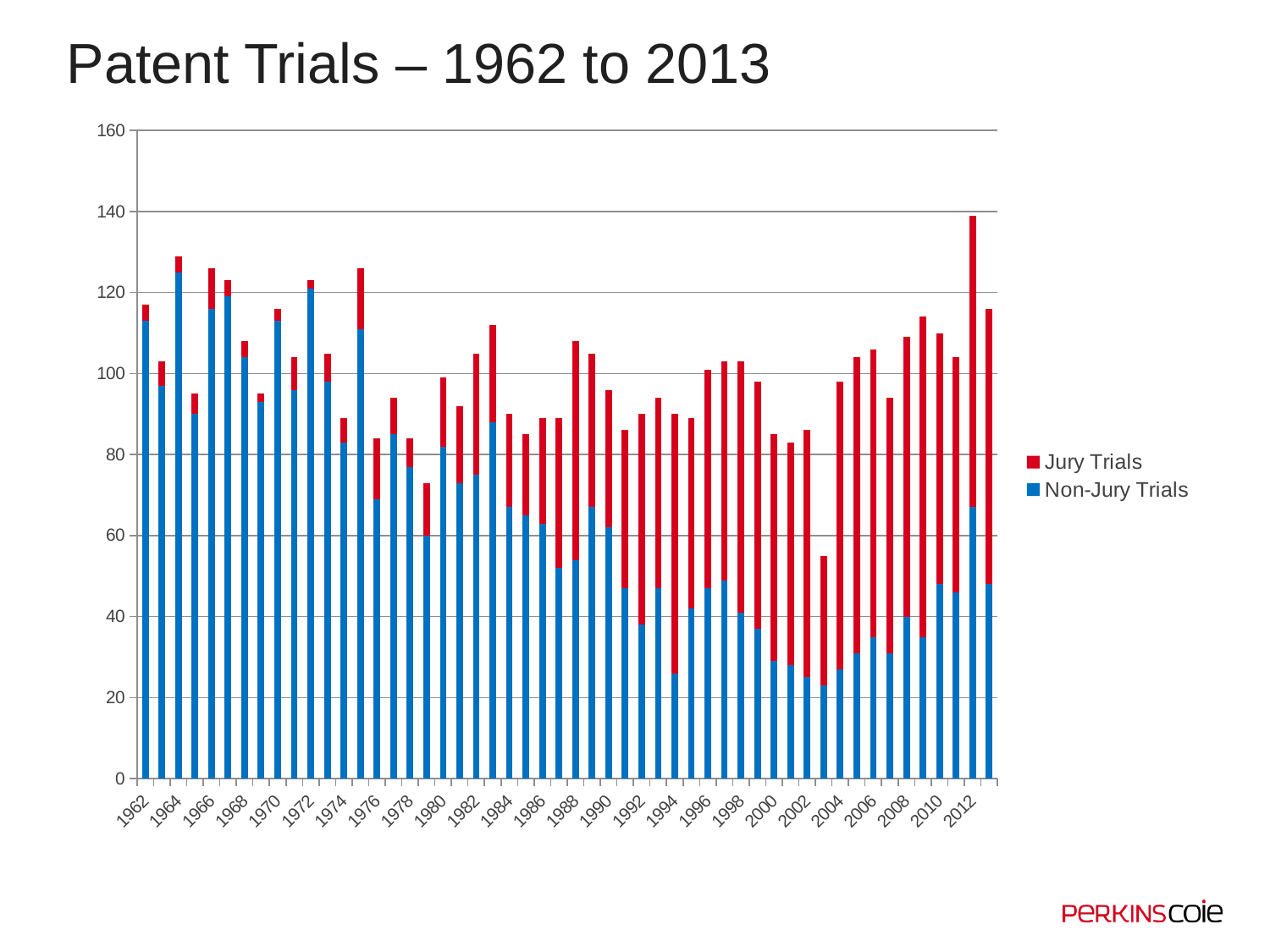
Which year has the lowest total number of patent trials? 2003 Is the total number of patent trials in 2012 greater or less than 120? greater Is the number of Non-Jury Trials in 1964 greater or less than 120? greater Do Non-Jury Trials generally rise or fall from 1962 to 2003? Fall Which year had more Non-Jury Trials, 1964 or 2013? 1964 Which year has the highest total number of patent trials? 2012 What kind of chart is shown on the slide? Stacked bar chart What are the two series named in the legend? Jury Trials and Non-Jury Trials Which colour represents Jury Trials in the chart? Red Which year had more total patent trials, 2012 or 2013? 2012 How many series does the legend list? 2 Is the total number of patent trials in 2003 greater or less than 60? less